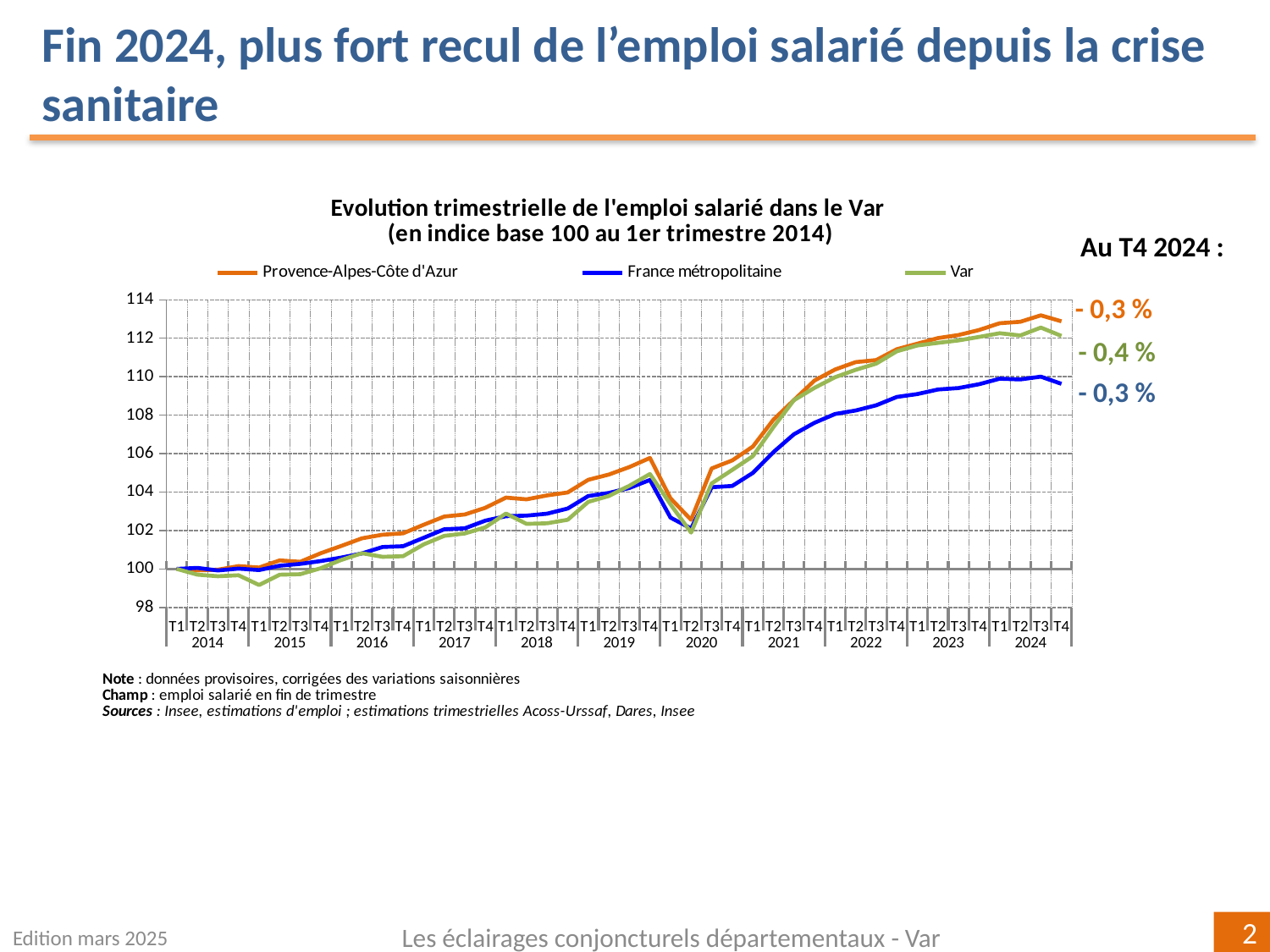
Is the value for Provence-Alpes-Côte d'Azur at T4 2024 greater or less than 112? greater Which series has the lowest index value at T4 2024? France métropolitaine Is the value for Var at T2 2020 greater or less than 104? less What kind of chart is shown on the slide? line chart What quarterly change is shown for France métropolitaine at T4 2024? - 0,3 % How many series does the legend list? 3 At T4 2024, which is higher: Provence-Alpes-Côte d'Azur or France métropolitaine? Provence-Alpes-Côte d'Azur Overall, do the index values rise or fall from 2014 to 2024? rise What quarterly change is shown for Var at T4 2024? - 0,4 % Which series are listed in the legend? Provence-Alpes-Côte d'Azur, France métropolitaine, Var What quarterly change is shown for Provence-Alpes-Côte d'Azur at T4 2024? - 0,3 % What is the title of the chart? Evolution trimestrielle de l'emploi salarié dans le Var (en indice base 100 au 1er trimestre 2014)